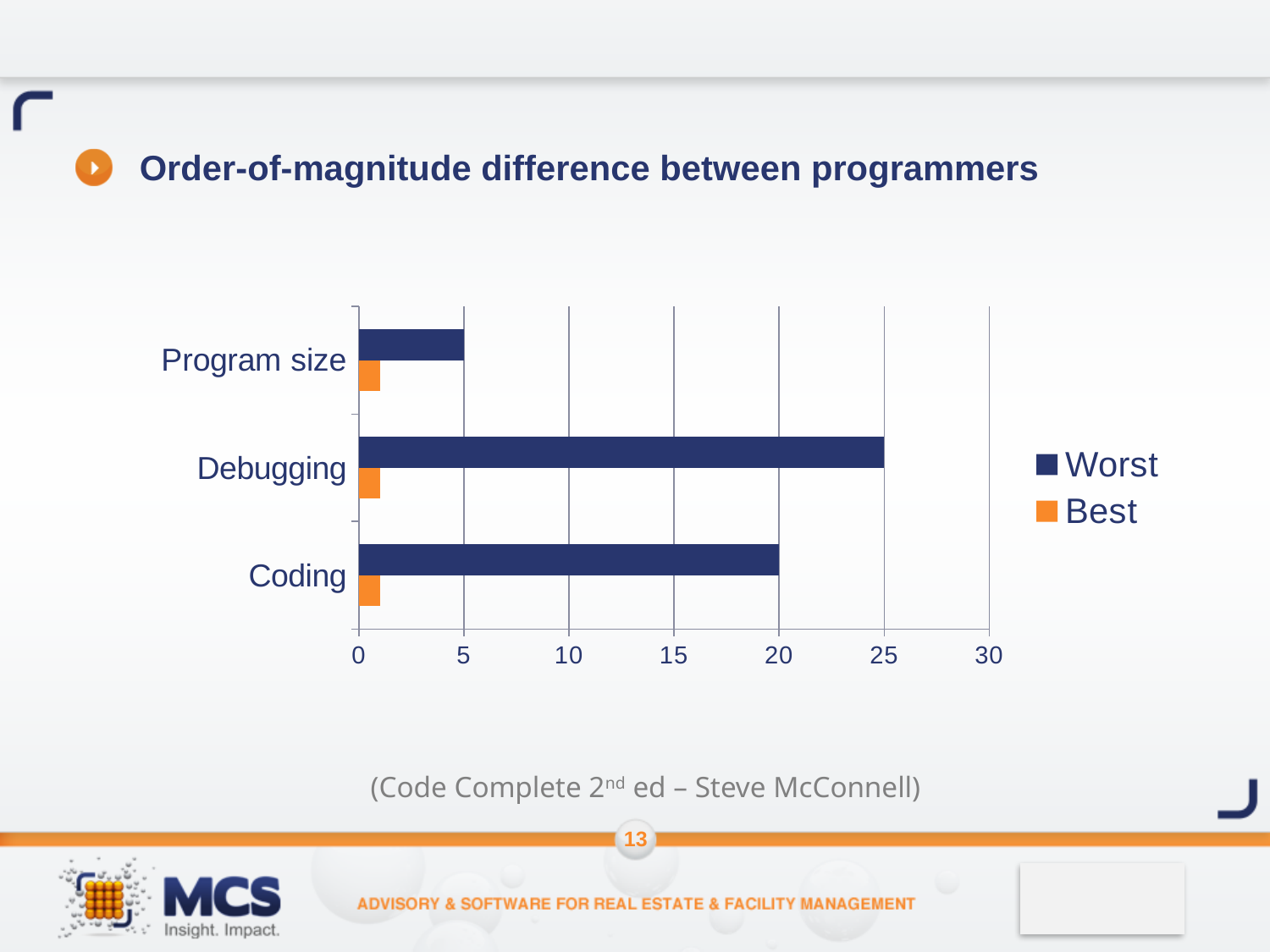
Is the Best value for Debugging greater or less than 5? less Which category has the highest Worst value? Debugging Which category has the lowest Worst value? Program size What is the Worst value for Program size? 5 What is the Worst value for Coding? 20 What are the two series named in the legend? Worst and Best Is the Worst value for Coding larger than the Worst value for Program size? Yes What is the difference between the Worst values for Debugging and Coding? 5 How many series does the legend list? 2 What kind of chart is shown on the slide? bar chart What is the Worst value for Debugging? 25 How many categories are shown on the chart? 3